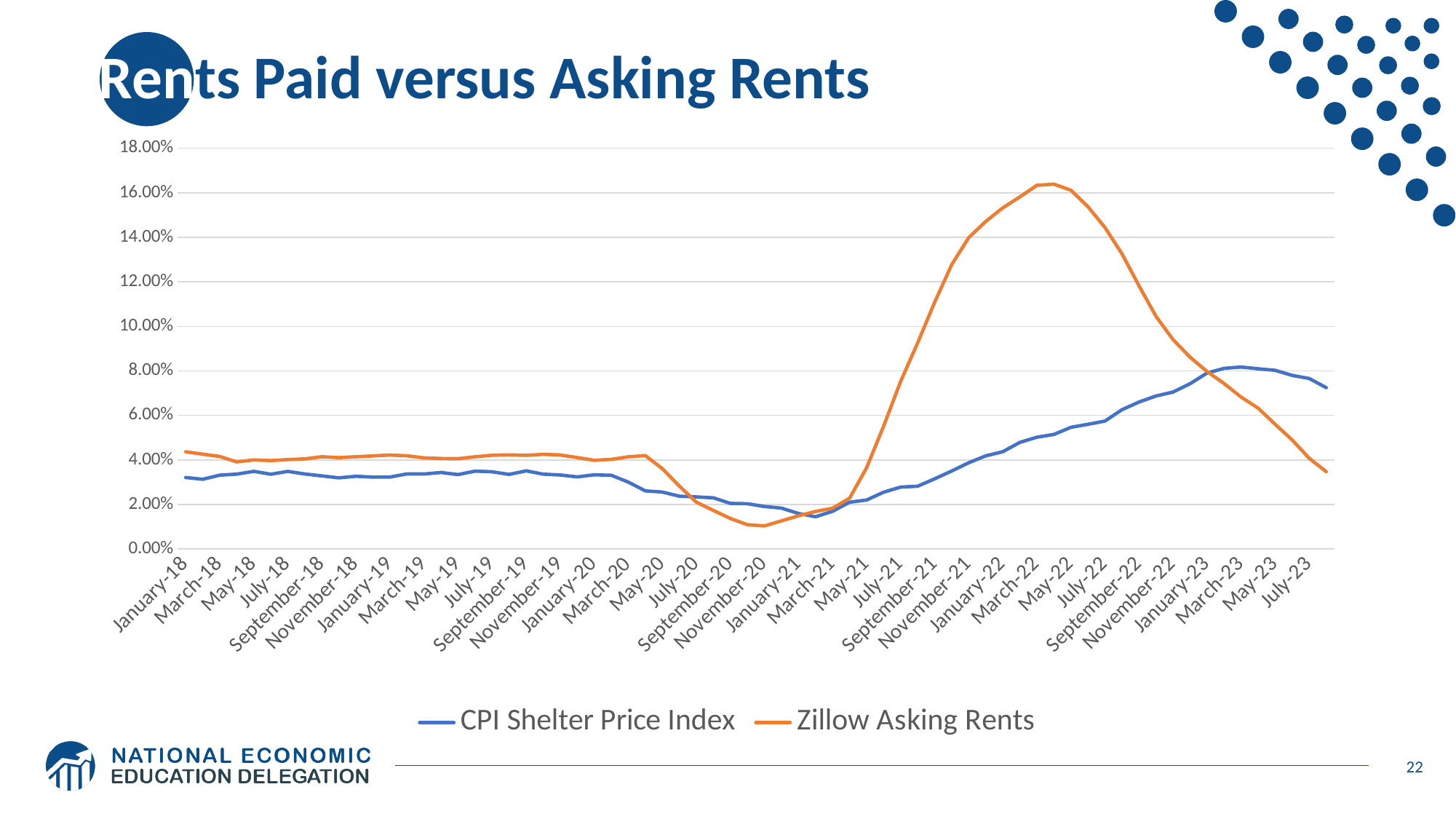
What is the title of the chart? Rents Paid versus Asking Rents Is the value for CPI Shelter Price Index in March-23 greater or less than 6.00%? greater Which series is drawn in orange? Zillow Asking Rents In March-22, which series has the higher value, CPI Shelter Price Index or Zillow Asking Rents? Zillow Asking Rents How many series does the legend list? 2 Does the Zillow Asking Rents line rise or fall between May-21 and March-22? rise Which series reaches the highest value anywhere on the chart? Zillow Asking Rents Is the value for Zillow Asking Rents in November-20 greater or less than 2.00%? less Is the value for Zillow Asking Rents in March-22 greater or less than 14.00%? greater In July-23, which series has the higher value, CPI Shelter Price Index or Zillow Asking Rents? CPI Shelter Price Index Does the Zillow Asking Rents line rise or fall between May-22 and July-23? fall What kind of chart is shown on the slide? line chart